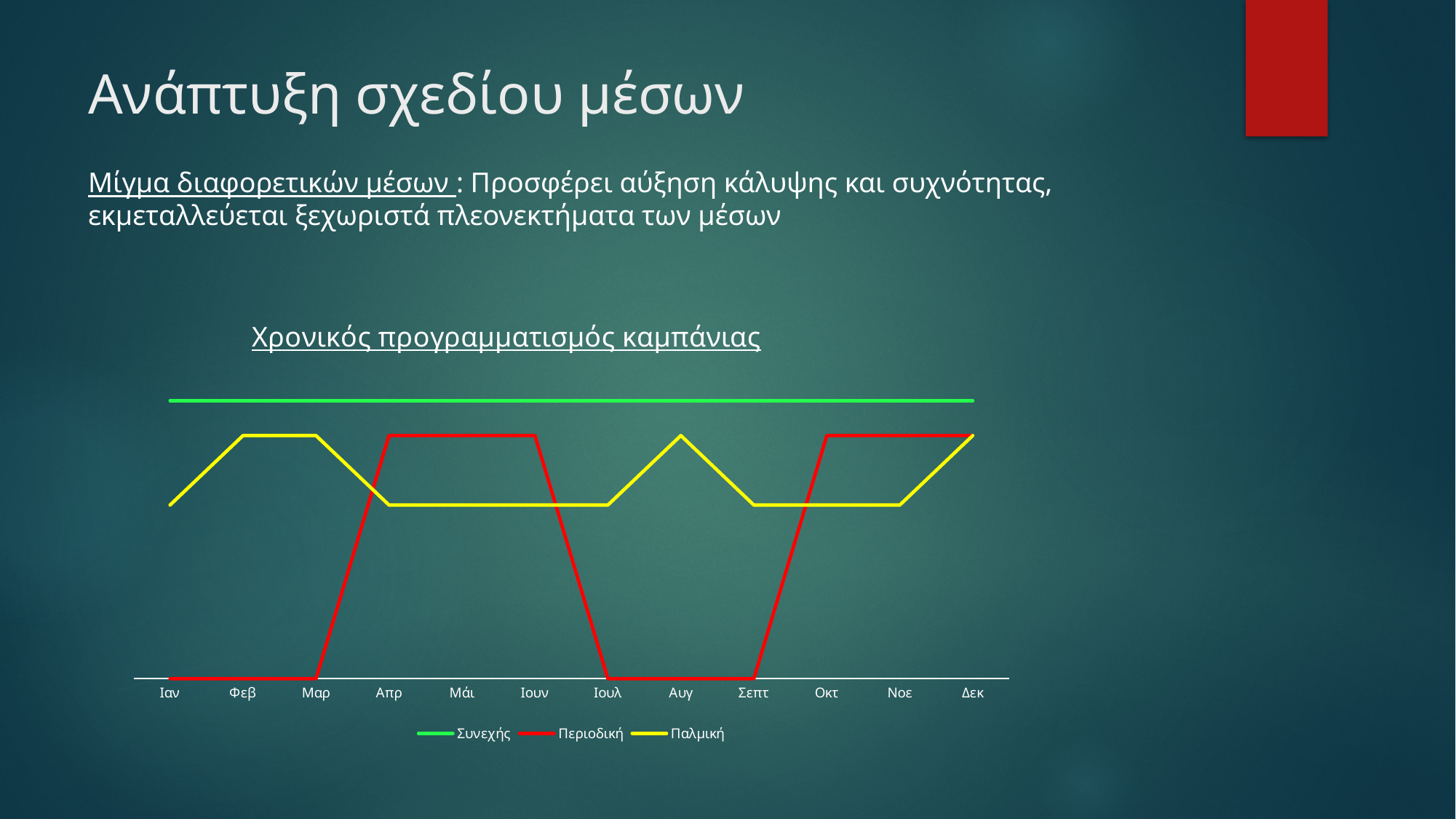
How many series does the chart legend list? 3 In Μάι, which is higher: Περιοδική or Παλμική? Περιοδική What kind of chart is shown on the slide? line chart Which series has the highest value in Ιαν? Συνεχής Does the Συνεχής series rise, fall or stay flat across the months? stay flat Does the Περιοδική series rise or fall from Ιουν to Ιουλ? fall Does the Παλμική series rise or fall from Ιαν to Φεβ? rise Which series has the lowest value in Ιουλ? Περιοδική How many months are shown on the x axis of the chart? 12 In Ιαν, which is higher: Συνεχής or Περιοδική? Συνεχής Which series is drawn in red in the chart? Περιοδική What is the title of the chart? Χρονικός προγραμματισμός καμπάνιας